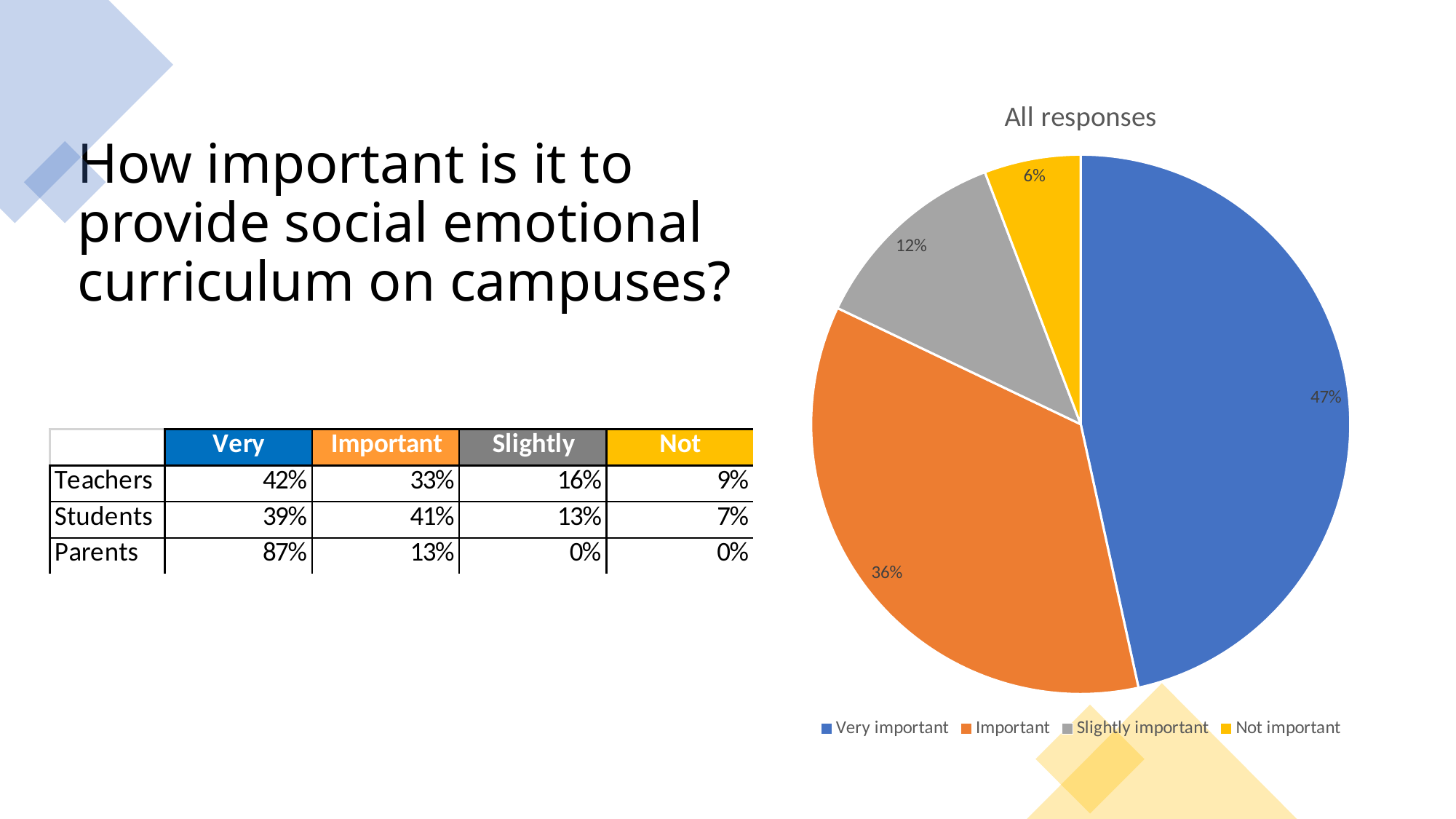
Which slice is larger, "Slightly important" or "Not important"? Slightly important Which category has the largest slice of the pie? Very important What share of the pie is labelled "Important"? 36% What kind of chart is shown on the slide? pie chart Which category has the smallest slice of the pie? Not important What share of the pie is labelled "Slightly important"? 12% How many slices does the pie chart have? 4 What share of the pie is labelled "Not important"? 6% What is the difference in percentage points between the "Very important" and "Important" slices? 11 What is the title of the chart? All responses How many entries does the legend list? 4